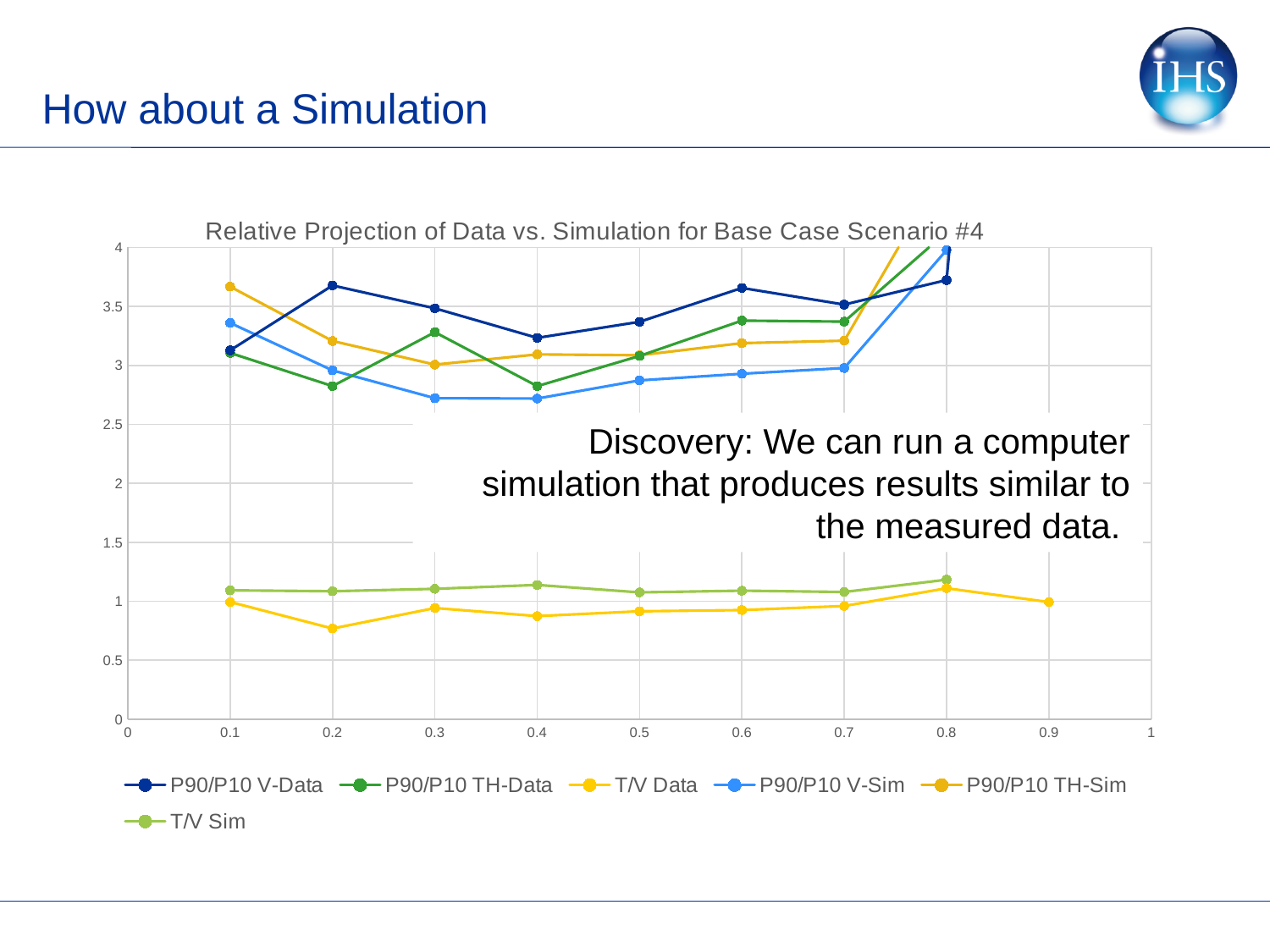
How many data points are plotted for the T/V Data series? 9 How many series does the chart legend list? 6 Is the value of T/V Data at x = 0.2 greater or less than 1? less What is the title of the chart? Relative Projection of Data vs. Simulation for Base Case Scenario #4 At x = 0.2, which is larger: P90/P10 V-Data or P90/P10 TH-Data? P90/P10 V-Data Is the value of P90/P10 V-Data at x = 0.2 greater or less than 3.5? greater At x = 0.1, which series has the highest value? P90/P10 TH-Sim Is the value of P90/P10 V-Sim at x = 0.4 greater or less than 3? less At x = 0.2, which series has the lowest value? T/V Data What kind of chart is shown on the slide? line chart Does the P90/P10 V-Sim series rise or fall between x = 0.1 and x = 0.4? fall